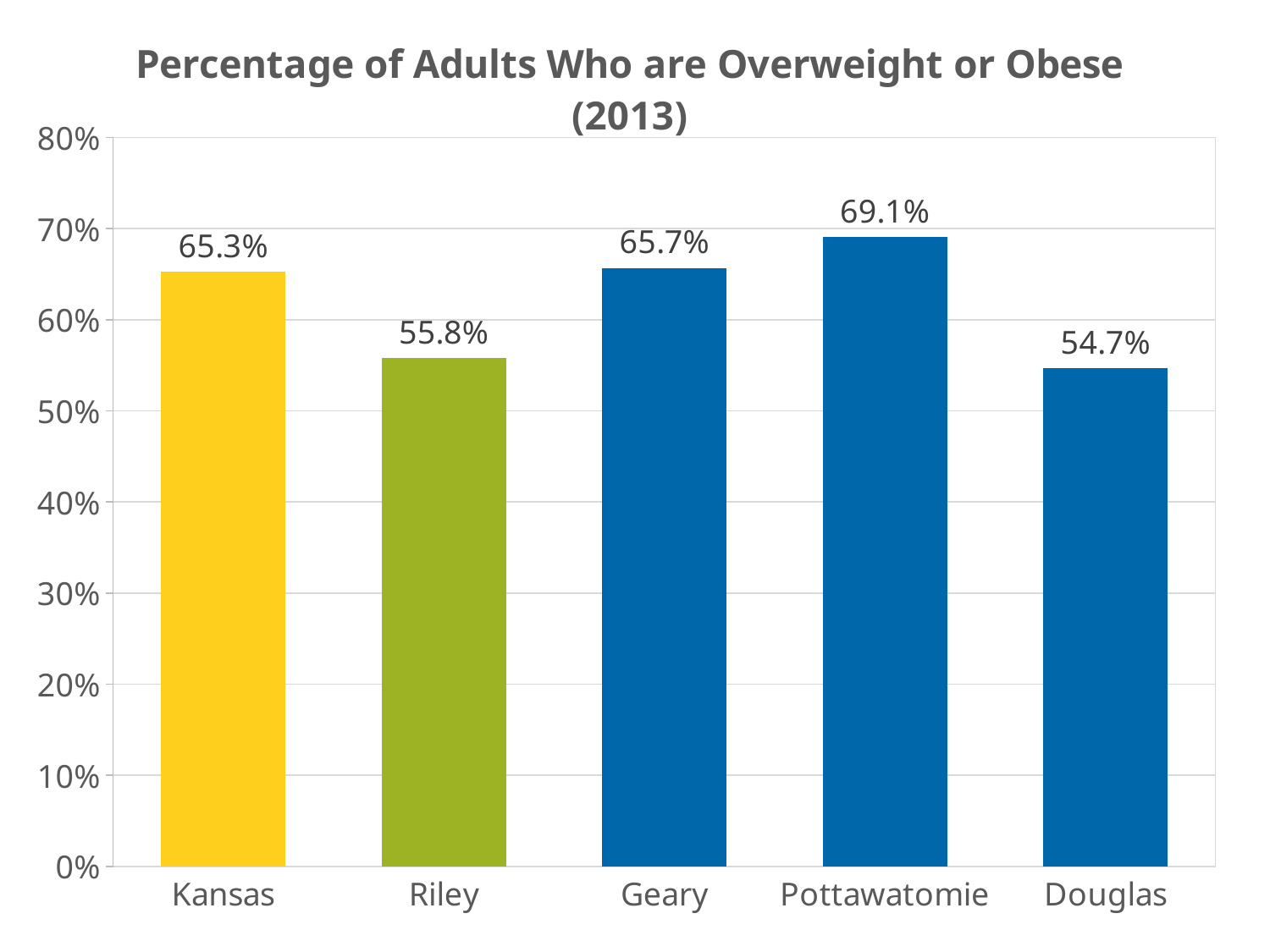
What kind of chart is shown on the slide? Bar chart What is the difference between the values for Geary and Kansas? 0.4% How many categories are shown on the chart? 5 Which has a larger value, Riley or Geary? Geary What is the percentage of adults who are overweight or obese in Kansas? 65.3% What is the title of the chart? Percentage of Adults Who are Overweight or Obese (2013) Which category has the highest percentage? Pottawatomie What is the difference between the values for Pottawatomie and Douglas? 14.4% What is the value shown for Pottawatomie? 69.1% Is the value for Douglas greater or less than 60%? less What is the value shown for Riley? 55.8% Which category has the lowest percentage? Douglas